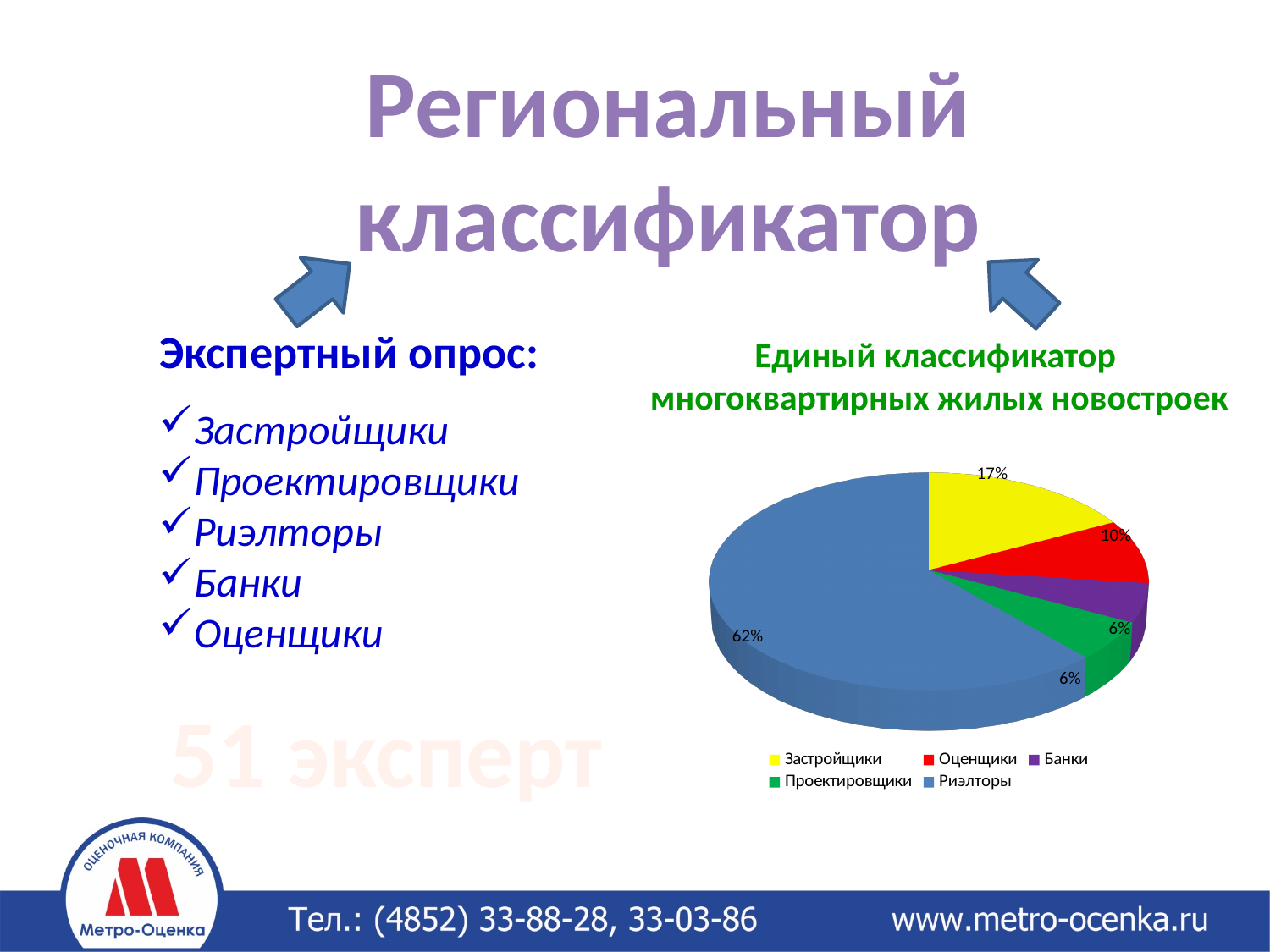
Which is larger in the pie chart, Застройщики or Оценщики? Застройщики What share of the pie chart is Оценщики? 10% What colour is the Проектировщики slice in the pie chart? green Which category is shown in yellow in the pie chart? Застройщики What kind of chart is shown on the slide? pie chart Which category has the largest slice in the pie chart? Риэлторы What share of the pie chart is Банки? 6% What share of the pie chart is Риэлторы? 62% How many categories does the pie chart legend list? 5 What share of the pie chart is Застройщики? 17% What is the difference between the Застройщики and Оценщики shares in the pie chart? 7% What is the difference between the Риэлторы and Застройщики shares in the pie chart? 45%